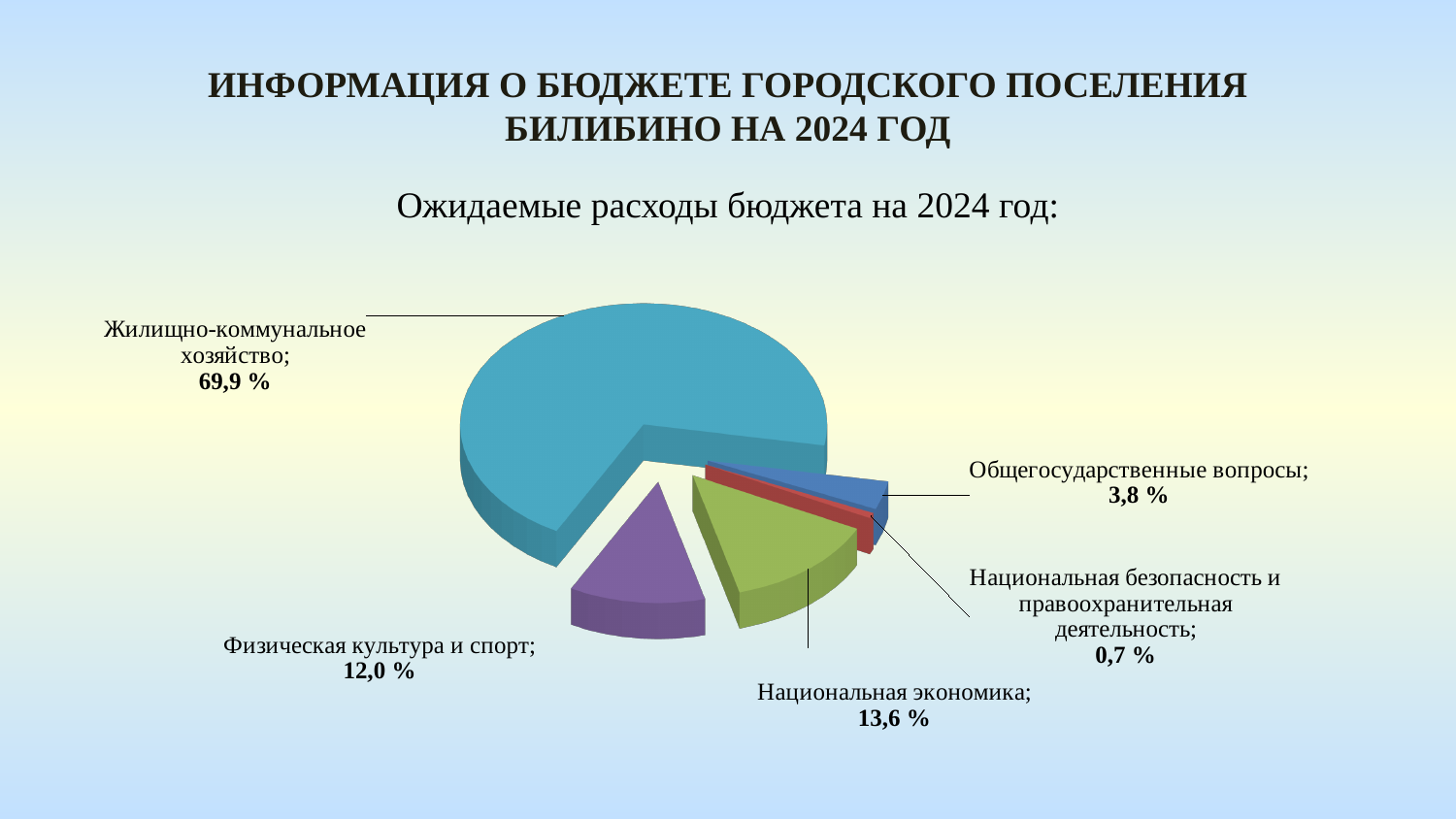
What is the difference in percentage points between Национальная экономика and Физическая культура и спорт? 1,6 What percentage is shown for Общегосударственные вопросы? 3,8 % What percentage is shown for Национальная безопасность и правоохранительная деятельность? 0,7 % How many slices does the pie chart have? 5 What percentage is shown for Национальная экономика? 13,6 % What kind of chart is shown on the slide? Pie chart Which is larger: the share for Национальная экономика or for Физическая культура и спорт? Национальная экономика Which category has the largest share of the pie? Жилищно-коммунальное хозяйство Which category has the smallest share of the pie? Национальная безопасность и правоохранительная деятельность What is the difference in percentage points between Общегосударственные вопросы and Национальная безопасность и правоохранительная деятельность? 3,1 What share of expected 2024 budget expenditures goes to Жилищно-коммунальное хозяйство? 69,9 % What percentage is shown for Физическая культура и спорт? 12,0 %